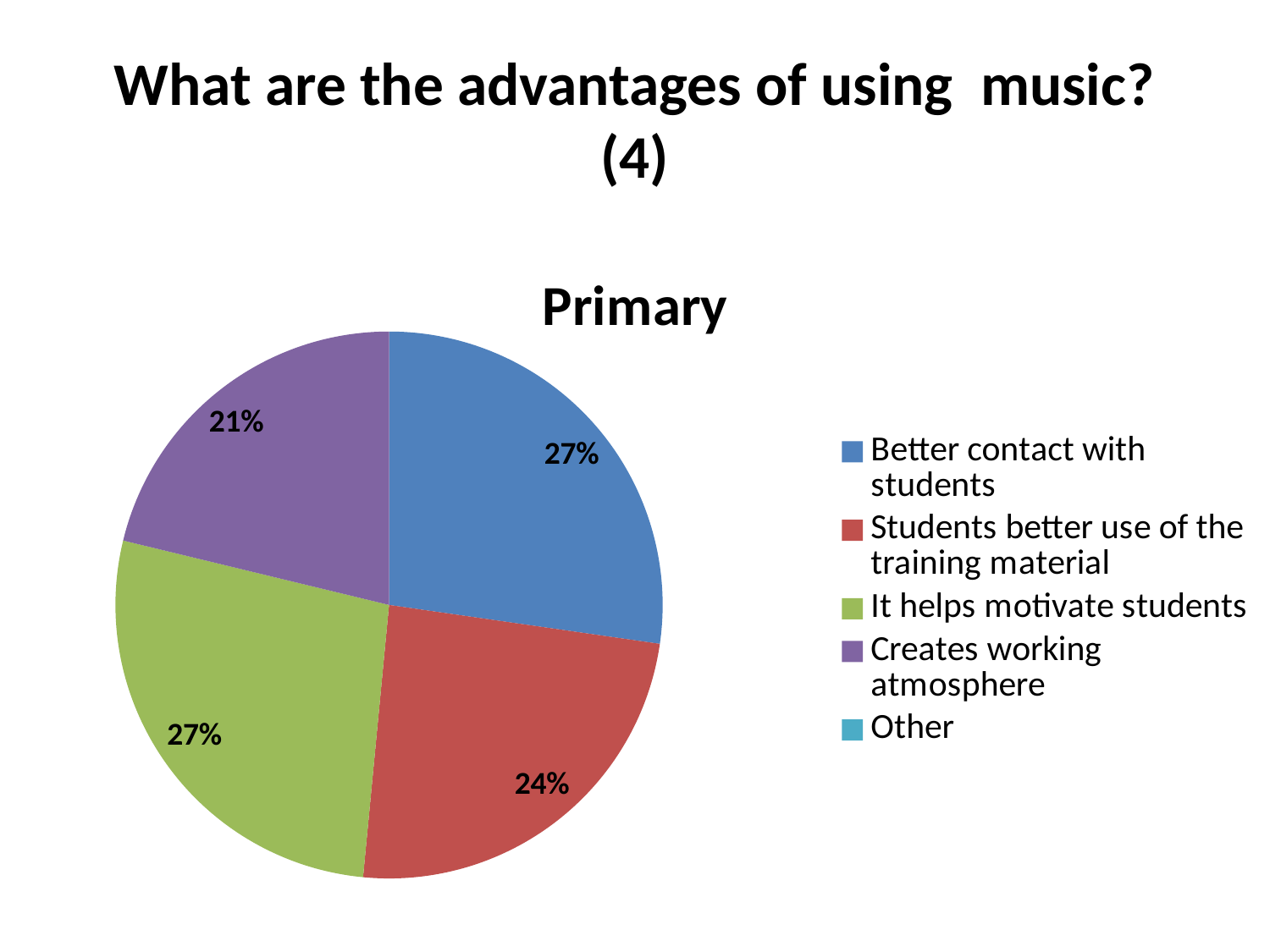
What share of the pie is labelled for "Students better use of the training material"? 24% Which labelled slice of the pie has the smallest share? Creates working atmosphere How many entries does the legend of the pie chart list? 5 What is the difference in percentage points between the share for "Students better use of the training material" and the share for "Creates working atmosphere"? 3 percentage points Which is larger: the share for "Better contact with students" or the share for "Students better use of the training material"? Better contact with students What share of the pie is labelled for "It helps motivate students"? 27% Which is larger: the share for "Creates working atmosphere" or the share for "It helps motivate students"? It helps motivate students What kind of chart is shown on the slide? pie chart What is the title of the pie chart? Primary What share of the pie is labelled for "Creates working atmosphere"? 21% What is the difference in percentage points between the share for "Better contact with students" and the share for "Creates working atmosphere"? 6 percentage points What share of the pie is labelled for "Better contact with students"? 27%